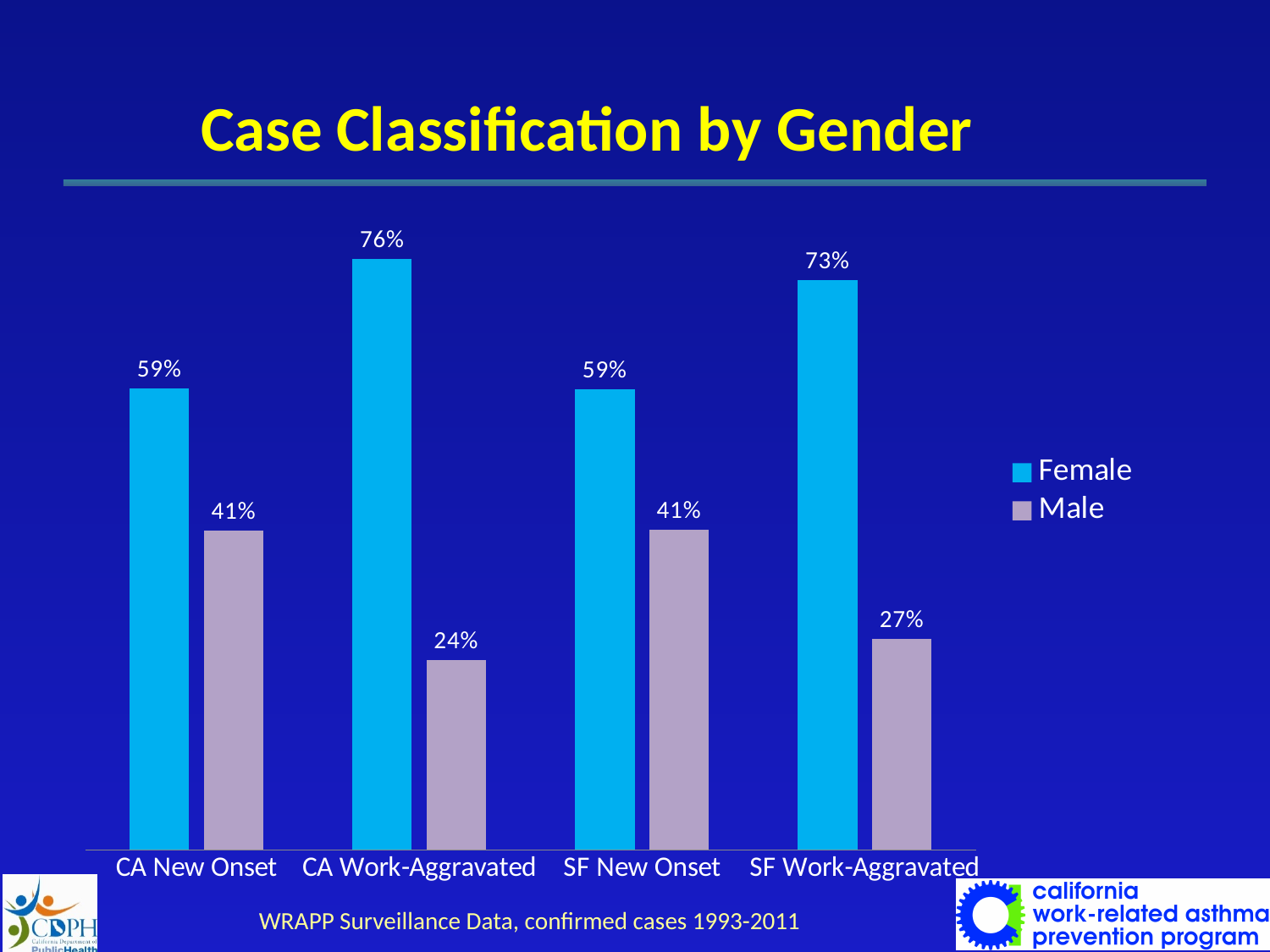
What kind of chart is shown on the slide? Bar chart Which is larger, the Male value for SF New Onset or the Male value for SF Work-Aggravated? SF New Onset How many series does the legend list? 2 Which category has the highest Female value? CA Work-Aggravated How many categories are shown on the x axis? 4 What is the title of the chart? Case Classification by Gender Which category has the lowest Male value? CA Work-Aggravated What is the Male value for SF Work-Aggravated? 27% What is the Male value for CA New Onset? 41% What is the difference between the Female and Male values for CA Work-Aggravated? 52% What is the Female value for SF Work-Aggravated? 73% What is the Female value for CA Work-Aggravated? 76%